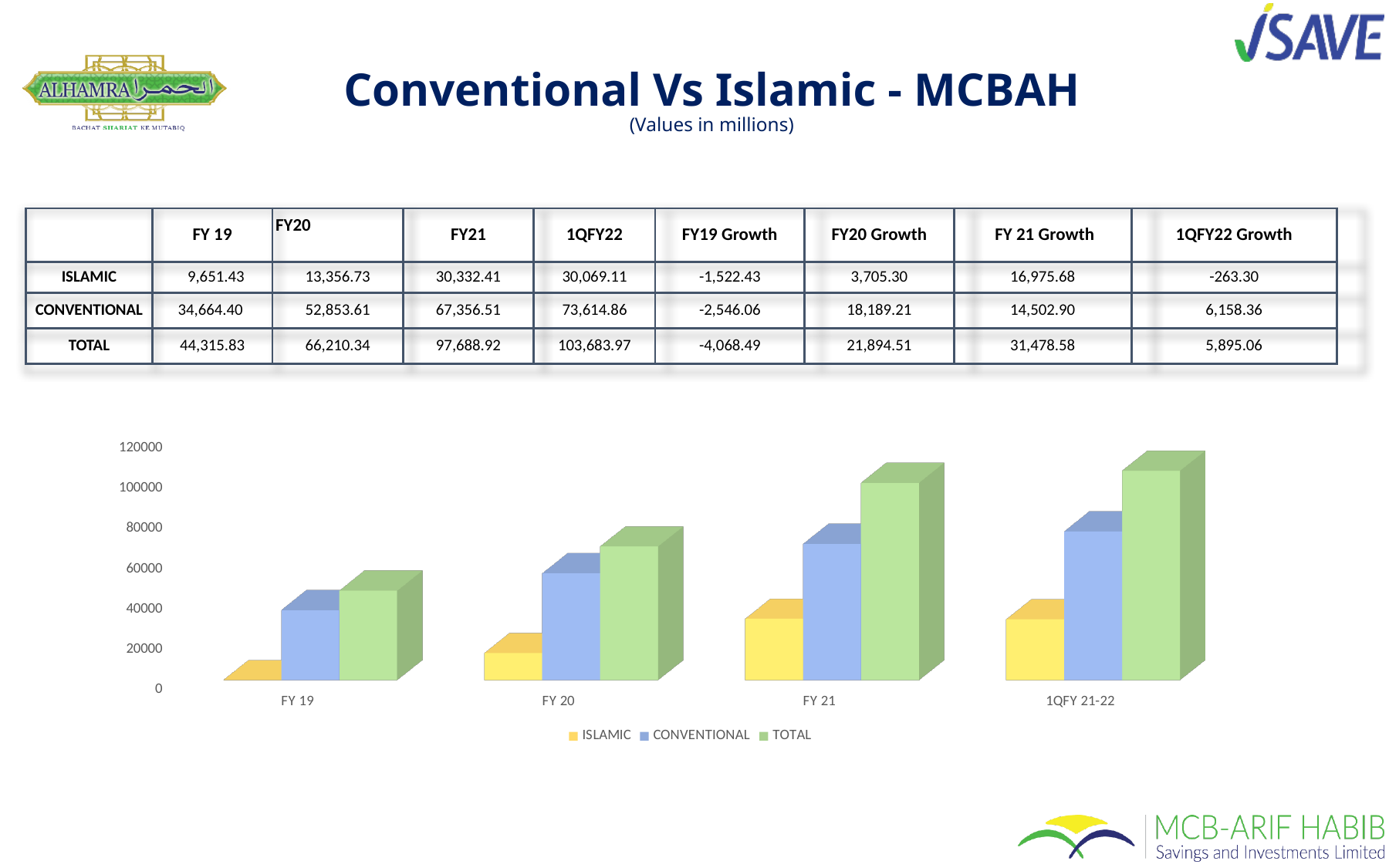
Is the ISLAMIC value for FY 19 in the chart greater or less than 20000? less Does the TOTAL series rise or fall from FY 19 to 1QFY 21-22 in the chart? rise What kind of chart is shown on the slide? bar chart Is the CONVENTIONAL value for FY 21 in the chart greater or less than 60000? greater Is the TOTAL value for 1QFY 21-22 in the chart greater or less than 100000? greater How many categories are shown along the x axis of the chart? 4 Which category has the tallest TOTAL bar in the chart? 1QFY 21-22 Which series does the green bar represent in the chart? TOTAL How many series does the chart legend list? 3 Which is larger in the chart: the CONVENTIONAL bar for FY 20 or the ISLAMIC bar for FY 21? CONVENTIONAL bar for FY 20 Which category has the shortest ISLAMIC bar in the chart? FY 19